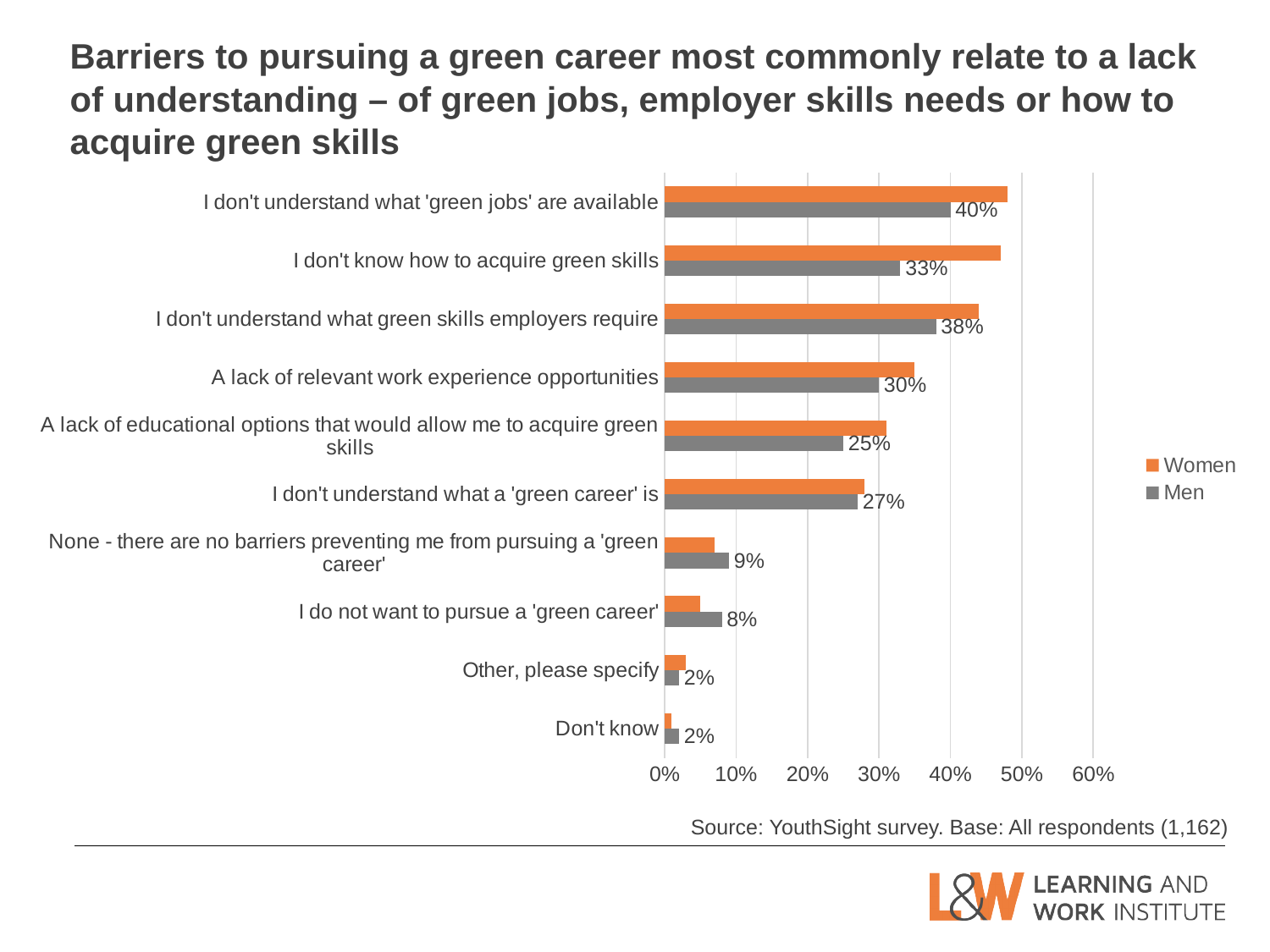
What is the value for Men for 'A lack of relevant work experience opportunities'? 30% What is the value for Men for 'I don't understand what 'green jobs' are available'? 40% Is the value for Women for 'I don't understand what 'green jobs' are available' greater or less than 40%? greater For 'I don't know how to acquire green skills', which is larger: the value for Women or the value for Men? Women Which colour represents Women in the legend? Orange Which category has the highest value for Men? I don't understand what 'green jobs' are available How many series does the legend list? 2 What kind of chart is shown on the slide? Bar chart Is the value for Women for 'I do not want to pursue a 'green career'' greater or less than 10%? less What is the value for Men for 'I don't know how to acquire green skills'? 33% How many categories are shown on the chart? 10 What is the difference between the Men values for 'I don't understand what 'green jobs' are available' and 'I don't know how to acquire green skills'? 7 percentage points